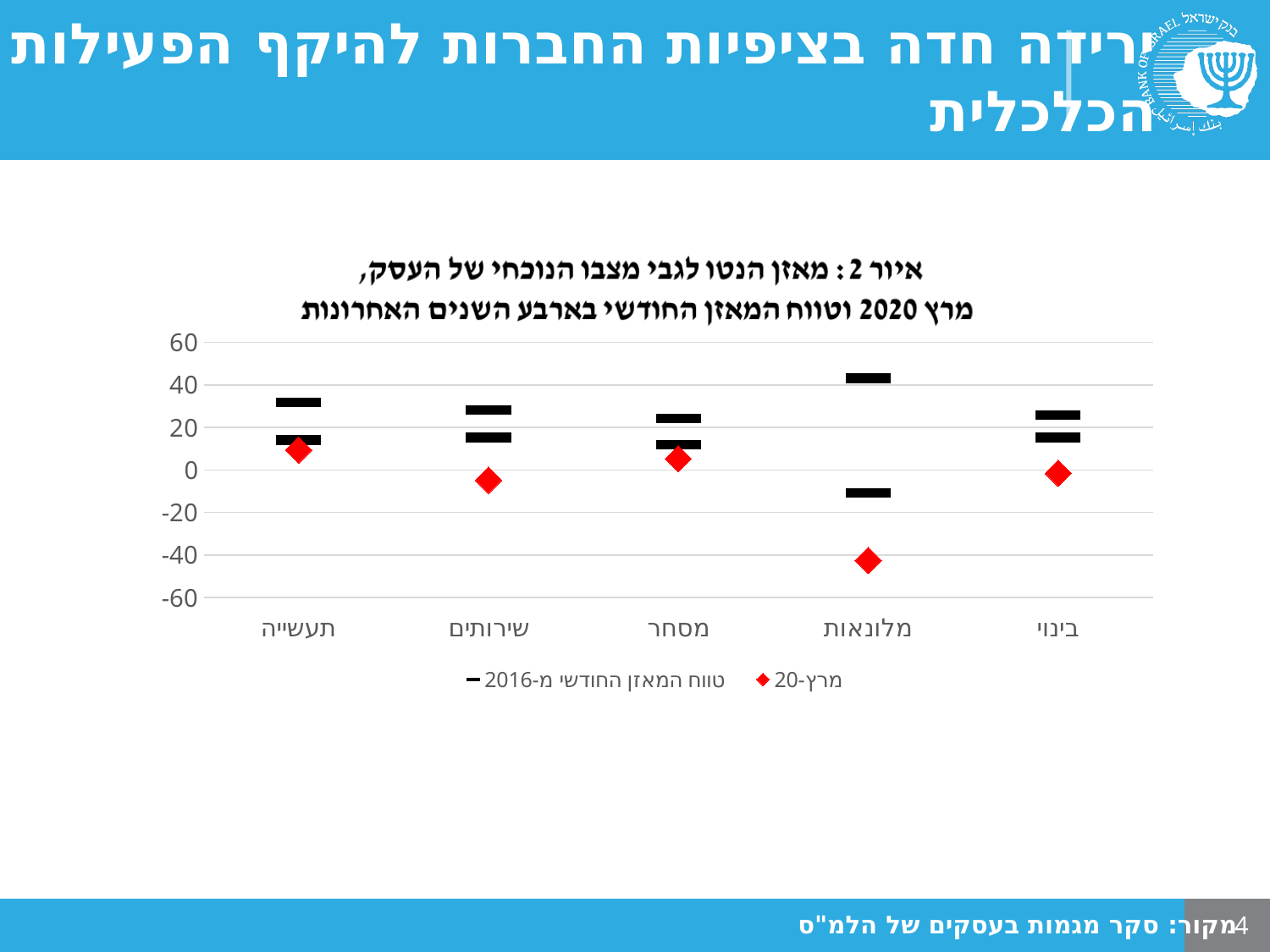
How many categories are shown on the x axis of the chart? 5 Which has the larger מרץ-20 value, תעשייה or מלונאות? תעשייה Is the מרץ-20 value for מסחר greater or less than 20? less Which category has the lowest value for the מרץ-20 series? מלונאות Which has the larger מרץ-20 value, שירותים or מלונאות? שירותים What colour are the markers for the מרץ-20 series? Red Is the מרץ-20 value for בינוי greater or less than 20? less What is the name of the second series listed in the legend, shown with black dashes? טווח המאזן החודשי מ-2016 Is the מרץ-20 value for תעשייה greater or less than 0? greater How many series does the chart legend list? 2